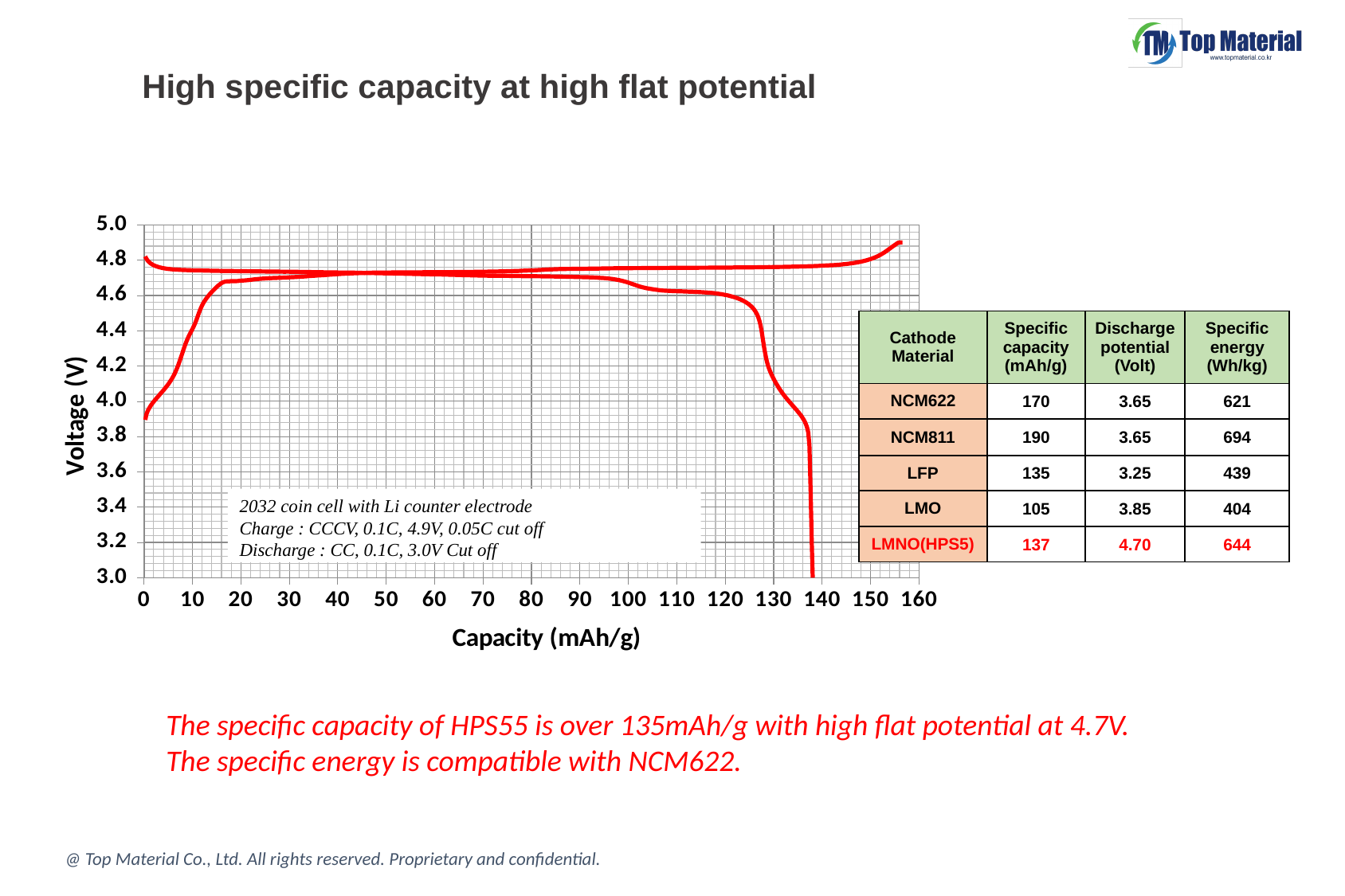
Is the voltage of the lower (discharge) curve at 60 mAh/g greater or less than 4.6 V? greater Does the upper (charge) curve end at a capacity greater or less than 150 mAh/g? greater Does the lower (discharge) curve rise or fall between 100 and 130 mAh/g? fall Is the voltage of the lower (discharge) curve at 130 mAh/g greater or less than 4.4 V? less What is the label of the y axis of the chart? Voltage (V) At 120 mAh/g, which curve has the higher voltage, the upper (charge) curve or the lower (discharge) curve? the upper (charge) curve What kind of chart is shown on the slide? line chart How many curves are plotted on the chart? 2 What is the label of the x axis of the chart? Capacity (mAh/g)